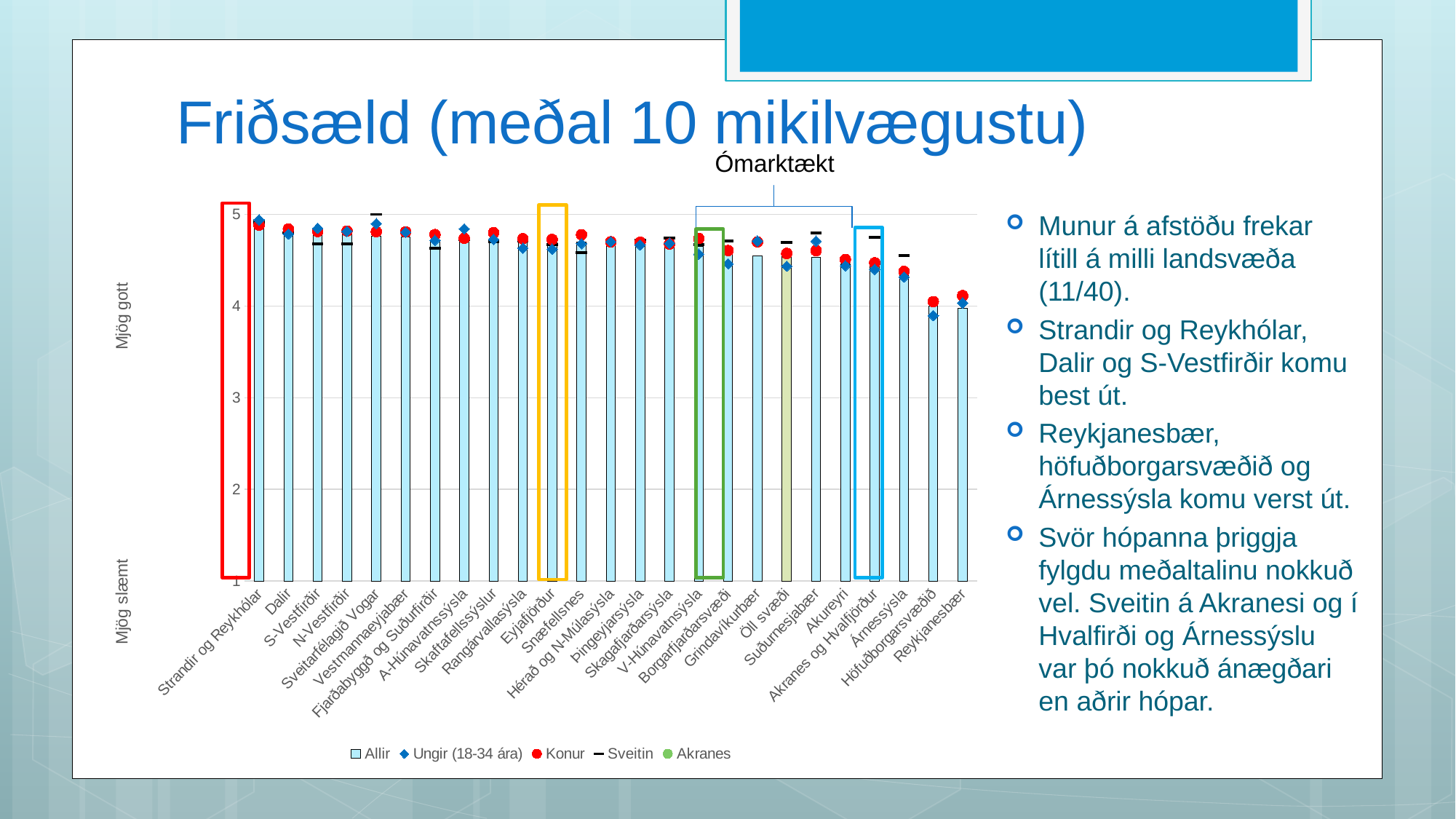
What is the title of the slide containing the chart? Friðsæld (meðal 10 mikilvægustu) What kind of chart is shown on the slide? bar chart Which region has the highest 'Allir' bar in the chart? Strandir og Reykhólar Do the 'Allir' bar values generally rise or fall from left to right along the x axis? fall Which has the larger 'Allir' value, Árnessýsla or Reykjanesbær? Árnessýsla Which legend entry is represented by a red circle marker? Konur Is the 'Allir' value for Reykjanesbær greater or less than 5? less How many series does the chart legend list? 5 Is the 'Allir' value for Strandir og Reykhólar greater or less than 4? greater Which has the larger 'Allir' value, Dalir or Höfuðborgarsvæðið? Dalir How many regions (categories) are shown along the x axis of the chart? 25 Is the 'Allir' value for Árnessýsla greater or less than 4? greater